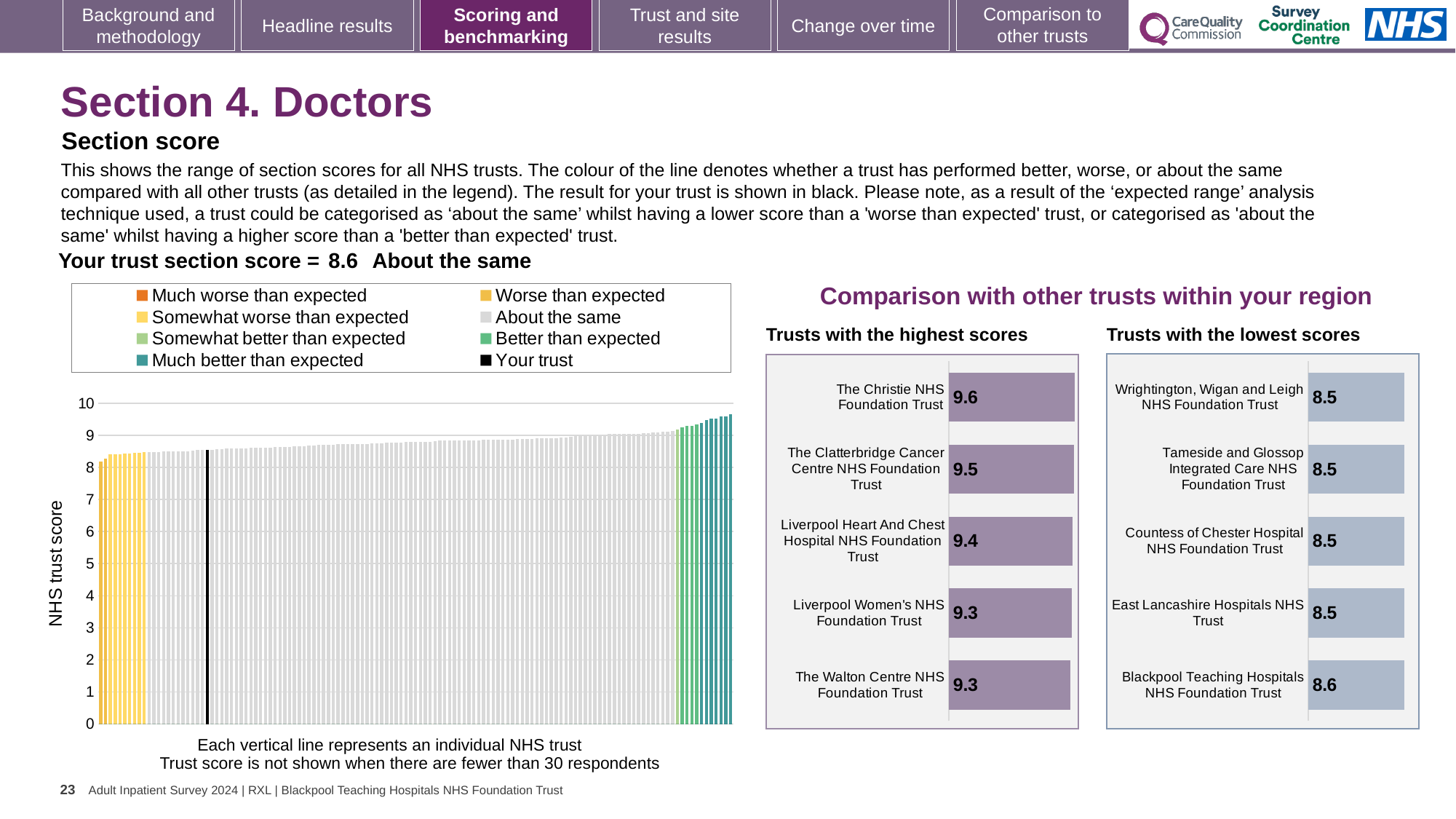
How many entries does the legend of the main 'NHS trust score' chart list? 8 In the main 'NHS trust score' chart, what colour is used for 'Your trust' according to the legend? Black In the 'Trusts with the highest scores' chart, what is the score for The Walton Centre NHS Foundation Trust? 9.3 In the main 'NHS trust score' chart, is the value of the tallest bar greater or less than 10? less How many trusts are shown in the 'Trusts with the highest scores' chart? 5 In the 'Trusts with the highest scores' chart, which trust has the highest score? The Christie NHS Foundation Trust In the 'Trusts with the lowest scores' chart, which has the larger score: Blackpool Teaching Hospitals NHS Foundation Trust or Countess of Chester Hospital NHS Foundation Trust? Blackpool Teaching Hospitals NHS Foundation Trust What kind of chart is the main 'NHS trust score' chart on the left? Bar chart In the 'Trusts with the highest scores' chart, what is the score for The Christie NHS Foundation Trust? 9.6 In the 'Trusts with the highest scores' chart, what is the difference between the scores of The Christie NHS Foundation Trust and Liverpool Women's NHS Foundation Trust? 0.3 In the main 'NHS trust score' chart, do the values rise or fall from left to right along the x axis? Rise In the 'Trusts with the lowest scores' chart, what is the score for Blackpool Teaching Hospitals NHS Foundation Trust? 8.6